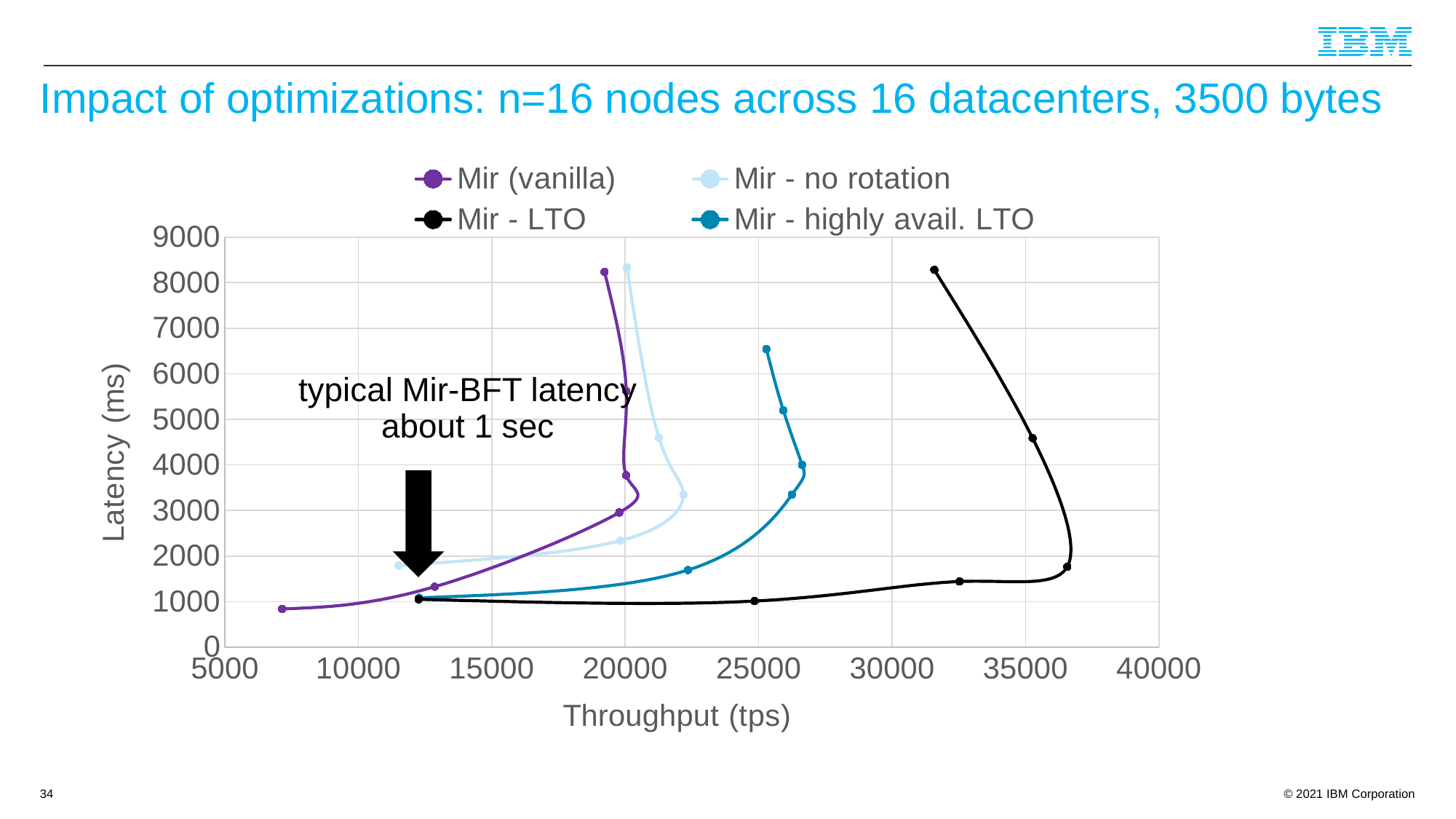
Is the highest latency of Mir - LTO greater or less than 8000? greater What kind of chart is shown on the slide? line chart Is the maximum throughput reached by Mir (vanilla) greater or less than 25000? less Which series has the point with the lowest throughput? Mir (vanilla) Is the highest latency of Mir - highly avail. LTO greater or less than 7000? less Which series reaches the highest throughput? Mir - LTO What is the label of the x axis? Throughput (tps) What is the label of the y axis? Latency (ms) How many series does the legend list? 4 How many data points are plotted for the Mir - LTO series? 6 Which series reaches a higher throughput, Mir - no rotation or Mir - highly avail. LTO? Mir - highly avail. LTO